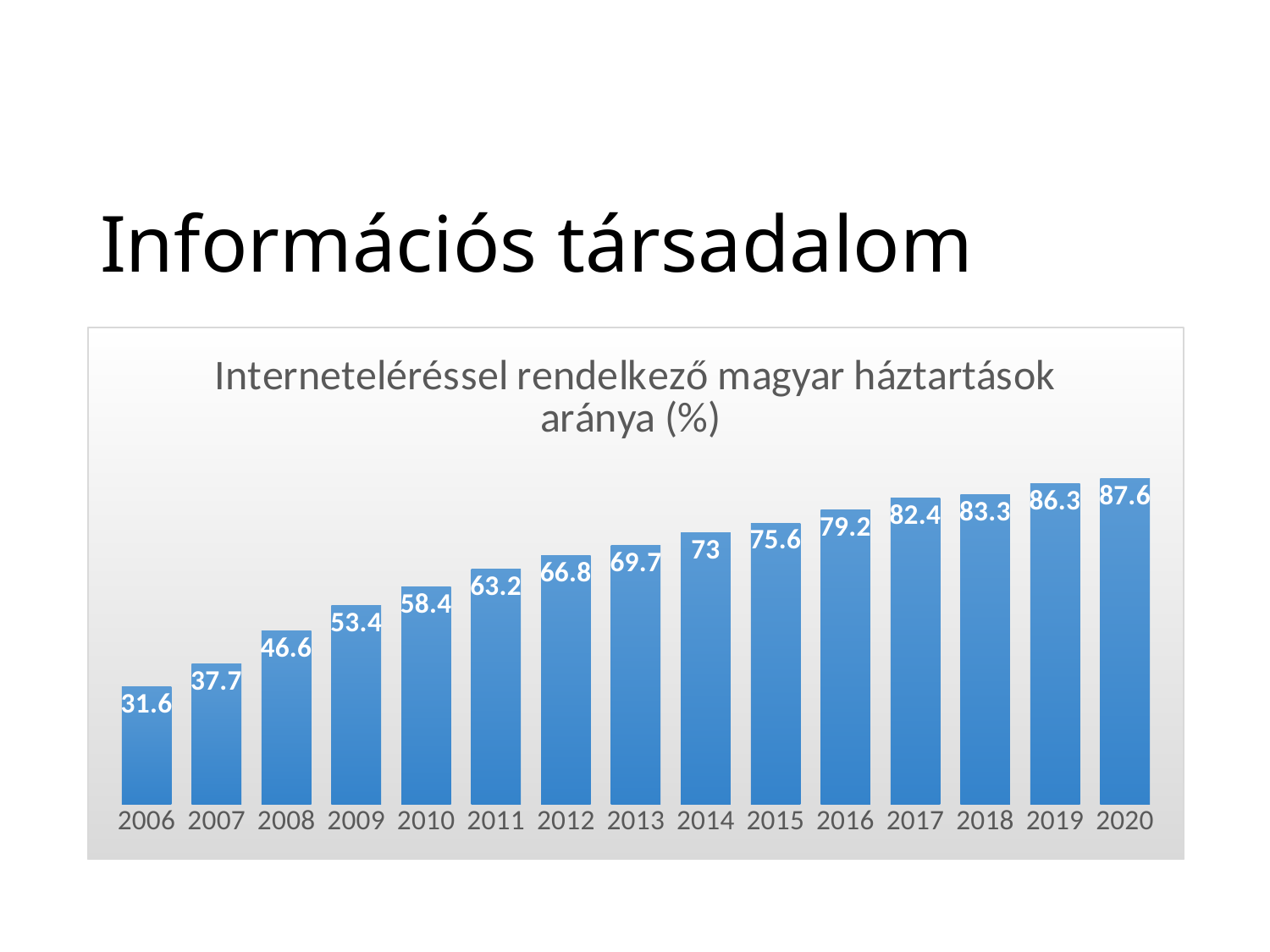
What is the difference between the values for 2010 and 2009? 5 What kind of chart is this? bar chart How many years are shown on the x axis? 15 What is the value for 2020? 87.6 Which is larger, the value for 2012 or the value for 2016? 2016 What is the value for 2014? 73 Which year has the lowest value? 2006 Which year has the highest value? 2020 What is the value for 2006? 31.6 What is the difference between the values for 2020 and 2006? 56 What is the value for 2011? 63.2 Do the values rise or fall from 2006 to 2020? rise